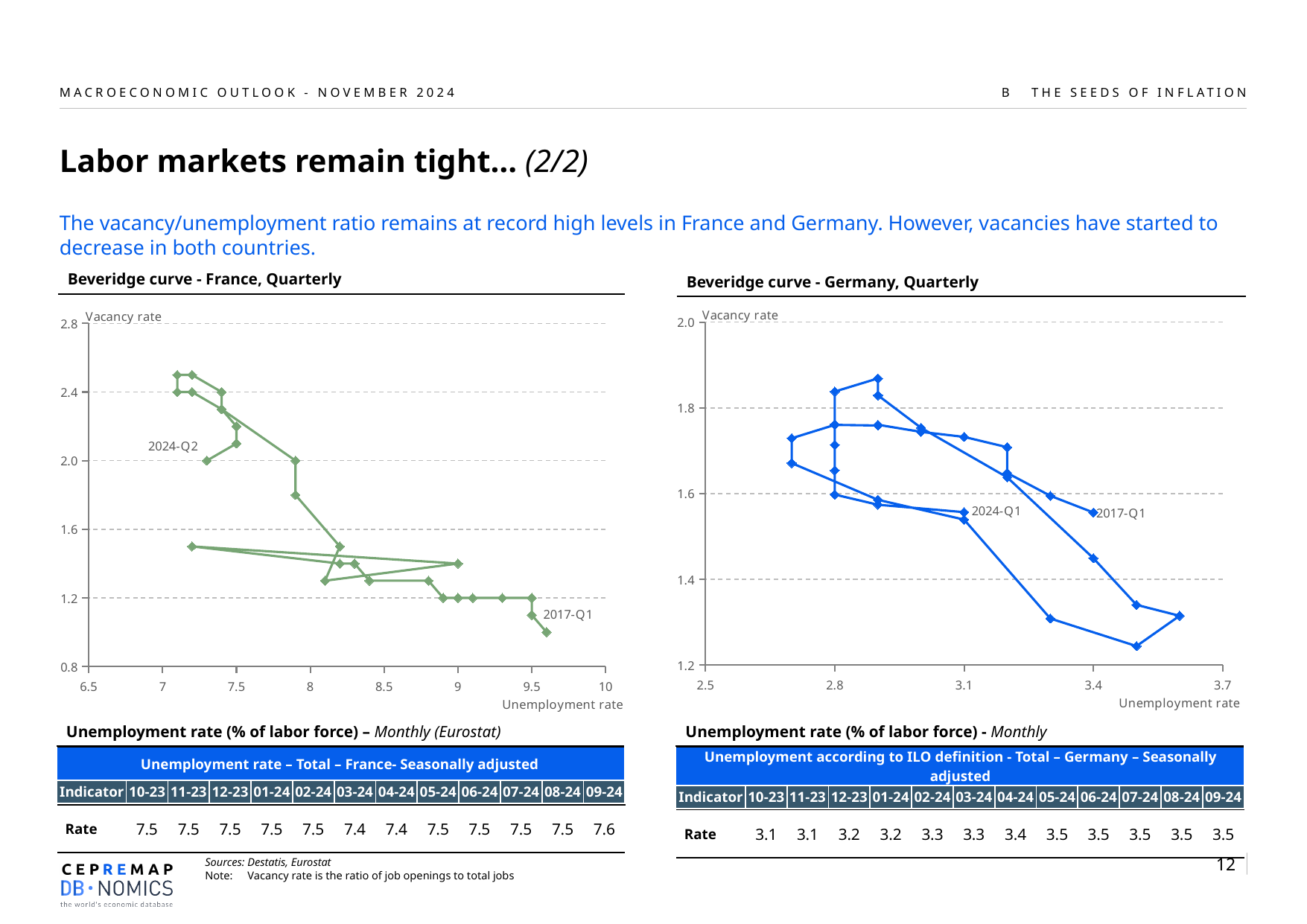
In the Germany unemployment table, what is the difference between the rate for 09-24 and the rate for 10-23? 0.4 In the Germany unemployment table, is the rate for 04-24 larger or smaller than the rate for 12-23? larger In the 'Beveridge curve - France, Quarterly' chart, is the unemployment rate for the point labelled 2017-Q1 greater or less than 9? greater In the 'Beveridge curve - Germany, Quarterly' chart, what variable is plotted on the vertical axis? Vacancy rate In the France unemployment table, which month has the highest rate? 09-24 In the Germany unemployment table, do the rates rise or fall from 10-23 to 09-24? rise In the Germany unemployment table, what is the rate for 09-24? 3.5 In the Germany unemployment table ('Unemployment according to ILO definition'), what is the rate for 10-23? 3.1 In the 'Unemployment rate – Total – France- Seasonally adjusted' table, what is the rate for 09-24? 7.6 In the 'Unemployment rate – Total – France- Seasonally adjusted' table, what is the rate for 03-24? 7.4 How many monthly columns does the France unemployment table contain? 12 In the France unemployment table, what is the difference between the rate for 09-24 and the rate for 03-24? 0.2